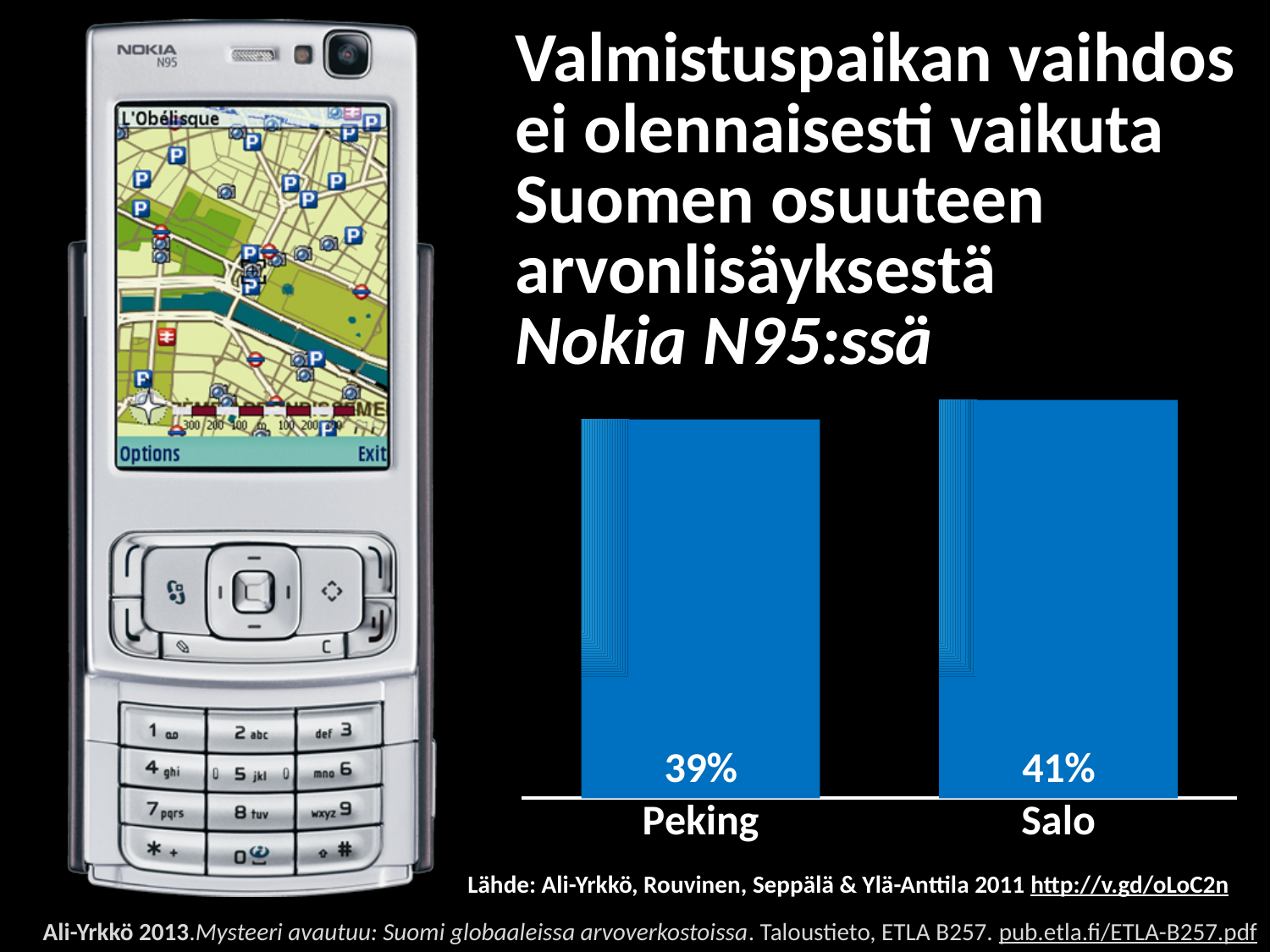
What is the value for Salo? 41% Which category has the lowest value? Peking Which is larger, the value for Peking or the value for Salo? Salo Do the values rise or fall from Peking to Salo? rise What kind of chart is shown on the slide? bar chart What is the value for Peking? 39% Which category has the highest value? Salo What are the two category labels on the x axis of the chart? Peking and Salo What colour are the bars in the chart? blue What is the difference between the values for Salo and Peking? 2% How many categories are shown in the chart? 2